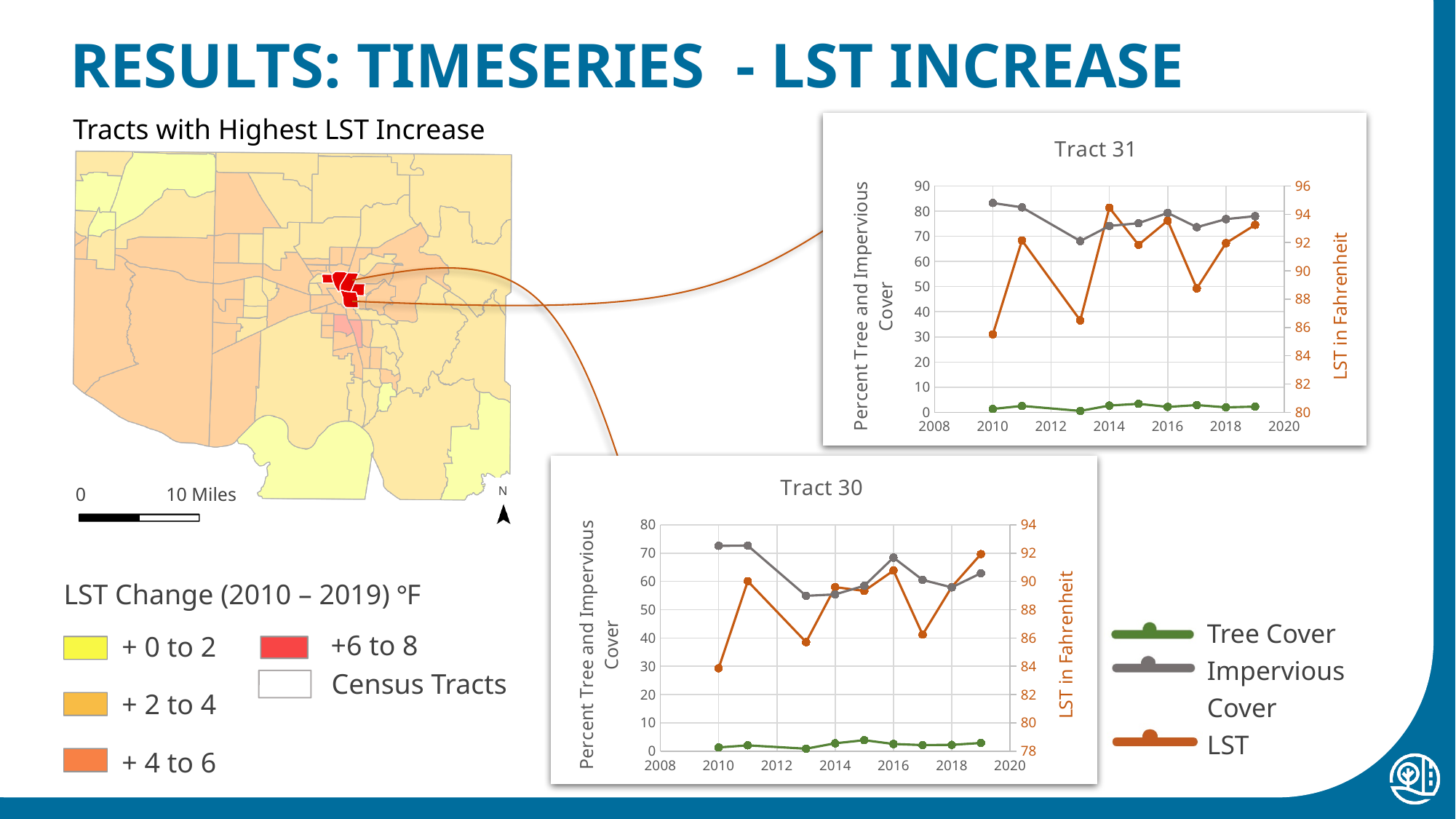
What kind of chart is the Tract 31 chart? line chart In the Tract 30 chart, which year has the highest LST value? 2019 In the Tract 30 chart, is the LST value for 2010 greater or less than 86? less In the Tract 31 chart, is the Impervious Cover value for 2010 greater or less than 80? greater What is the label of the right-hand vertical axis on the Tract 30 chart? LST in Fahrenheit In the Tract 31 chart, how many years are plotted for the LST series? 9 In the Tract 30 chart, does the Impervious Cover series rise or fall overall from 2010 to 2019? fall In the Tract 30 chart, is the Impervious Cover value for 2010 greater or less than 70? greater In the Tract 31 chart, which is larger: the Impervious Cover value in 2010 or in 2019? 2010 In the Tract 30 chart, which year has the lowest LST value? 2010 How many series does the legend list for the Tract 30 and Tract 31 charts? 3 In the Tract 31 chart, which year has the highest LST value? 2014